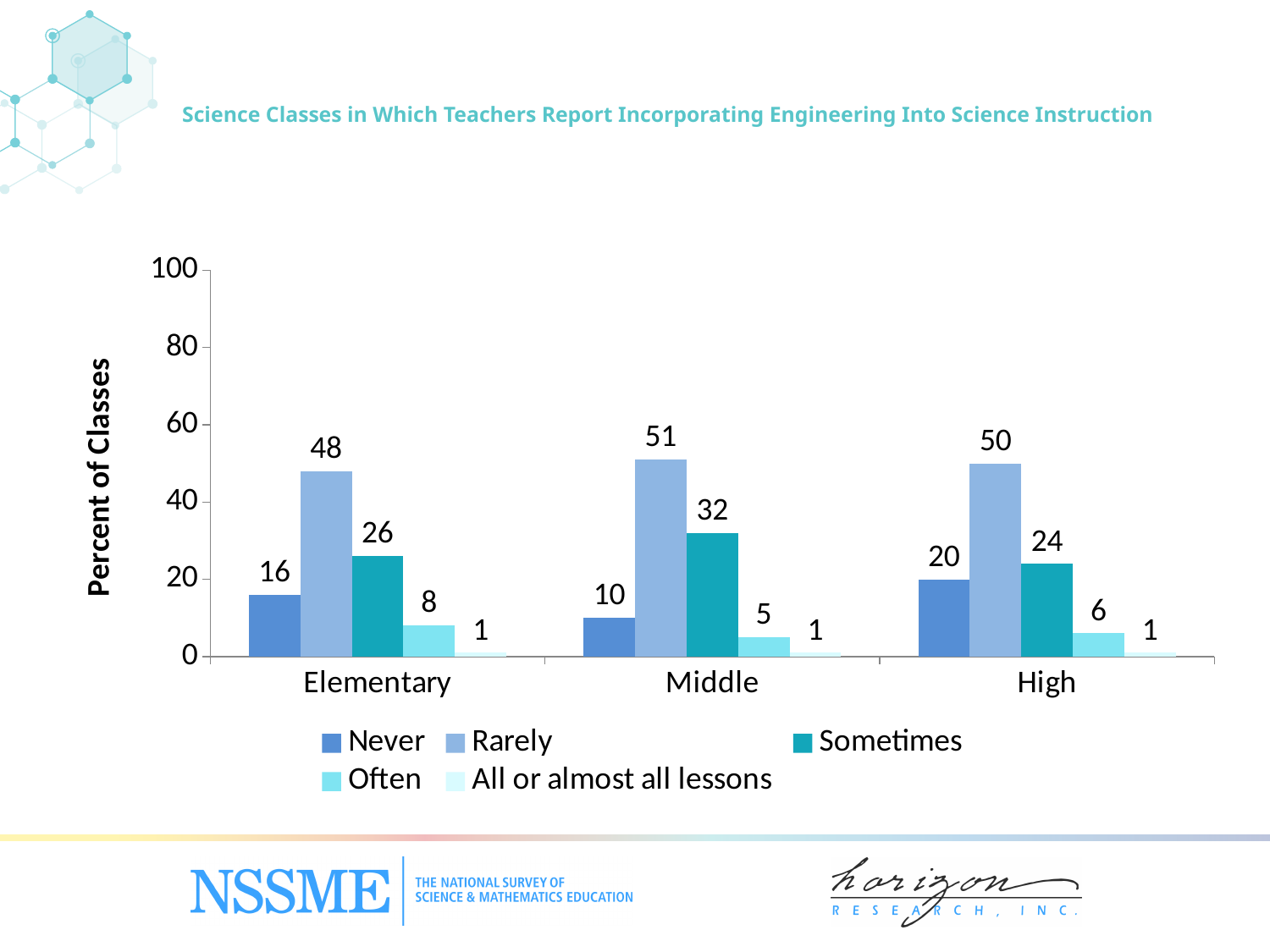
What is the value for 'Never' in High school science classes? 20 How many series does the legend list? 5 What percent of Elementary science classes report 'Rarely' incorporating engineering into science instruction? 48 Which grade level has the lowest value for 'Never'? Middle What is the value for 'Sometimes' in Middle school science classes? 32 Which grade level has the highest value for 'Rarely'? Middle What is the label on the y axis? Percent of Classes How many grade-level categories are shown on the x axis? 3 What is the difference between the 'Sometimes' values for Middle and High school classes? 8 Is the value for 'Rarely' in High school classes greater or less than 40? greater Is the 'Often' value larger for Elementary or for Middle school classes? Elementary What kind of chart is shown on the slide? Bar chart